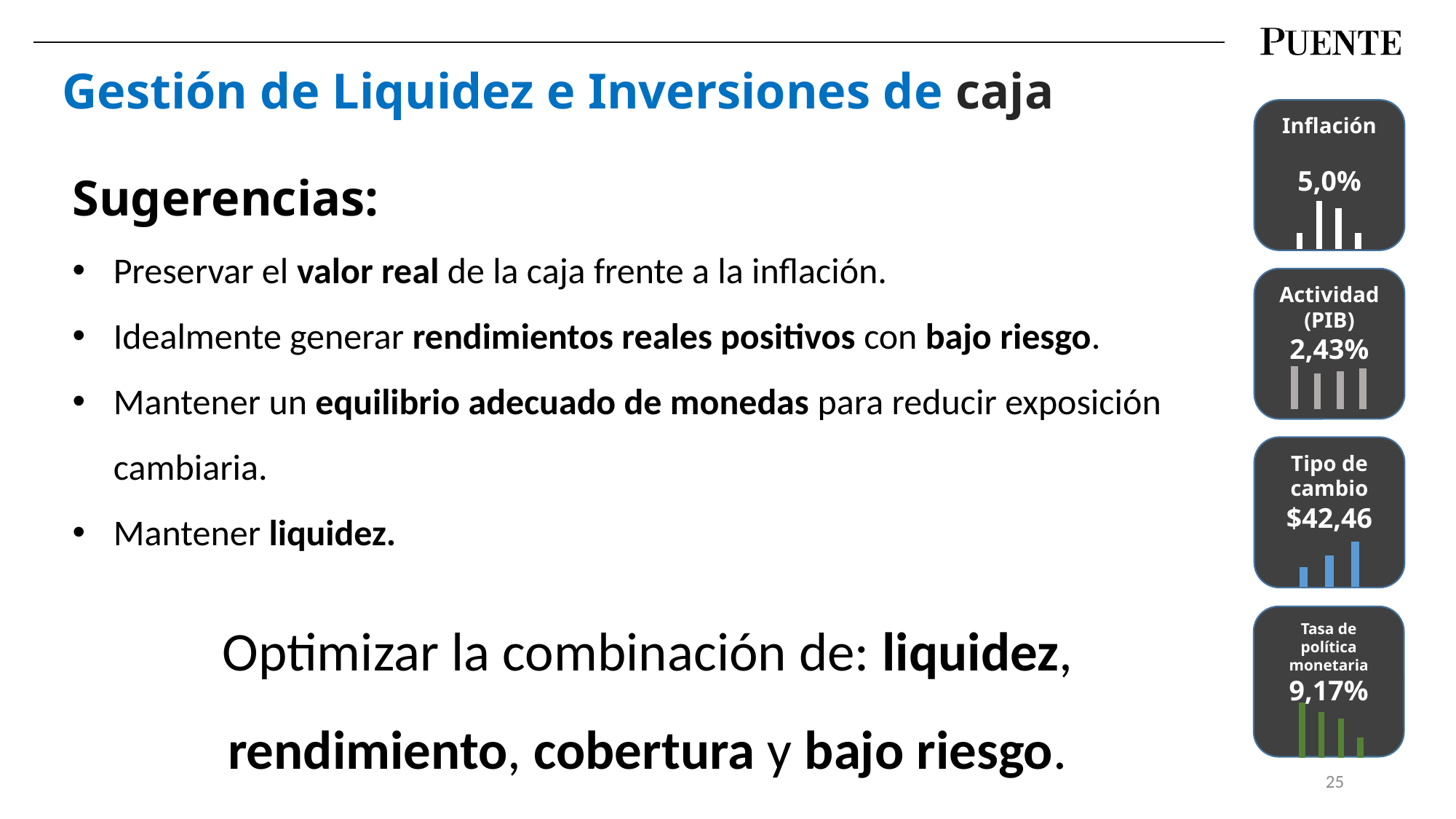
Which printed percentage is larger, the Inflación value or the Tasa de política monetaria value? Tasa de política monetaria On the Tipo de cambio chart, do the bars rise or fall from left to right? rise What kind of chart is shown in the Tipo de cambio panel? bar chart On the Actividad (PIB) chart, what value is printed? 2,43% How many bars are shown on the Tipo de cambio chart? 3 On the Inflación chart, what value is printed? 5,0% On the Tasa de política monetaria chart, what value is printed? 9,17% On the Tipo de cambio chart, what value is printed? $42,46 How many bars are shown on the Actividad (PIB) chart? 4 What colour are the bars on the Tasa de política monetaria chart? green On the Tasa de política monetaria chart, do the bars rise or fall from left to right? fall How many small charts are shown in the right-hand panel of the slide? 4